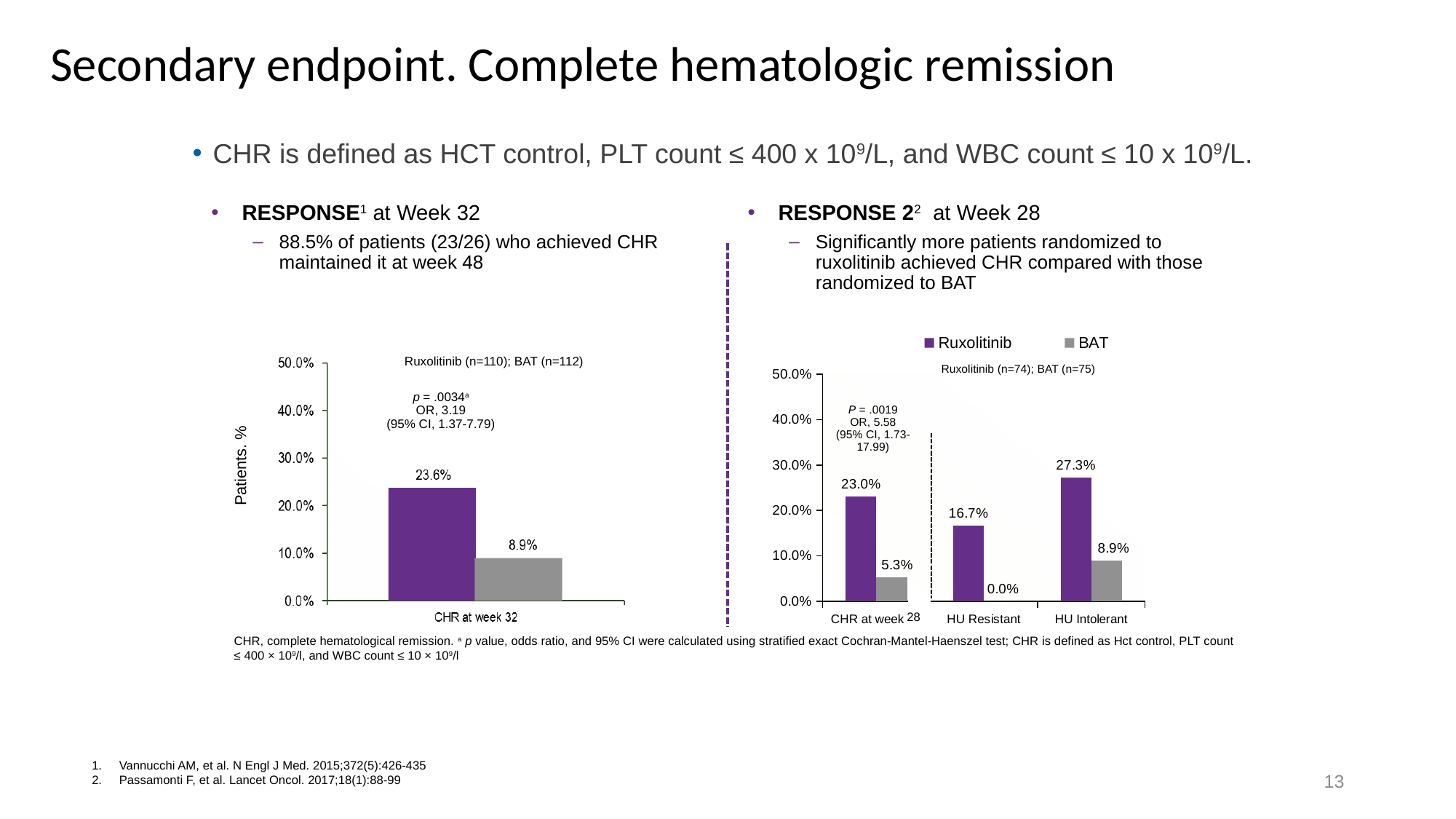
In the right chart (RESPONSE 2 at Week 28), how many categories are shown on the x axis? 3 In the right chart (RESPONSE 2 at Week 28), what is the difference between the Ruxolitinib and BAT values for HU Intolerant? 18.4% In the right chart (RESPONSE 2 at Week 28), how many series does the legend list? 2 What type of chart is the right chart (RESPONSE 2 at Week 28)? Bar chart In the right chart (RESPONSE 2 at Week 28), what is the Ruxolitinib value for HU Intolerant? 27.3% In the right chart (RESPONSE 2 at Week 28), what is the BAT value for HU Resistant? 0.0% In the left chart (RESPONSE at Week 32), what is the label on the y axis? Patients, % In the left chart (RESPONSE at Week 32), what value is shown on the purple bar for CHR at week 32? 23.6% In the right chart (RESPONSE 2 at Week 28), what is the Ruxolitinib value for CHR at week 28? 23.0% In the right chart (RESPONSE 2 at Week 28), which category has the highest Ruxolitinib value? HU Intolerant In the left chart (RESPONSE at Week 32), what value is shown on the gray bar for CHR at week 32? 8.9% In the left chart (RESPONSE at Week 32), what is the difference between the purple bar and the gray bar? 14.7%